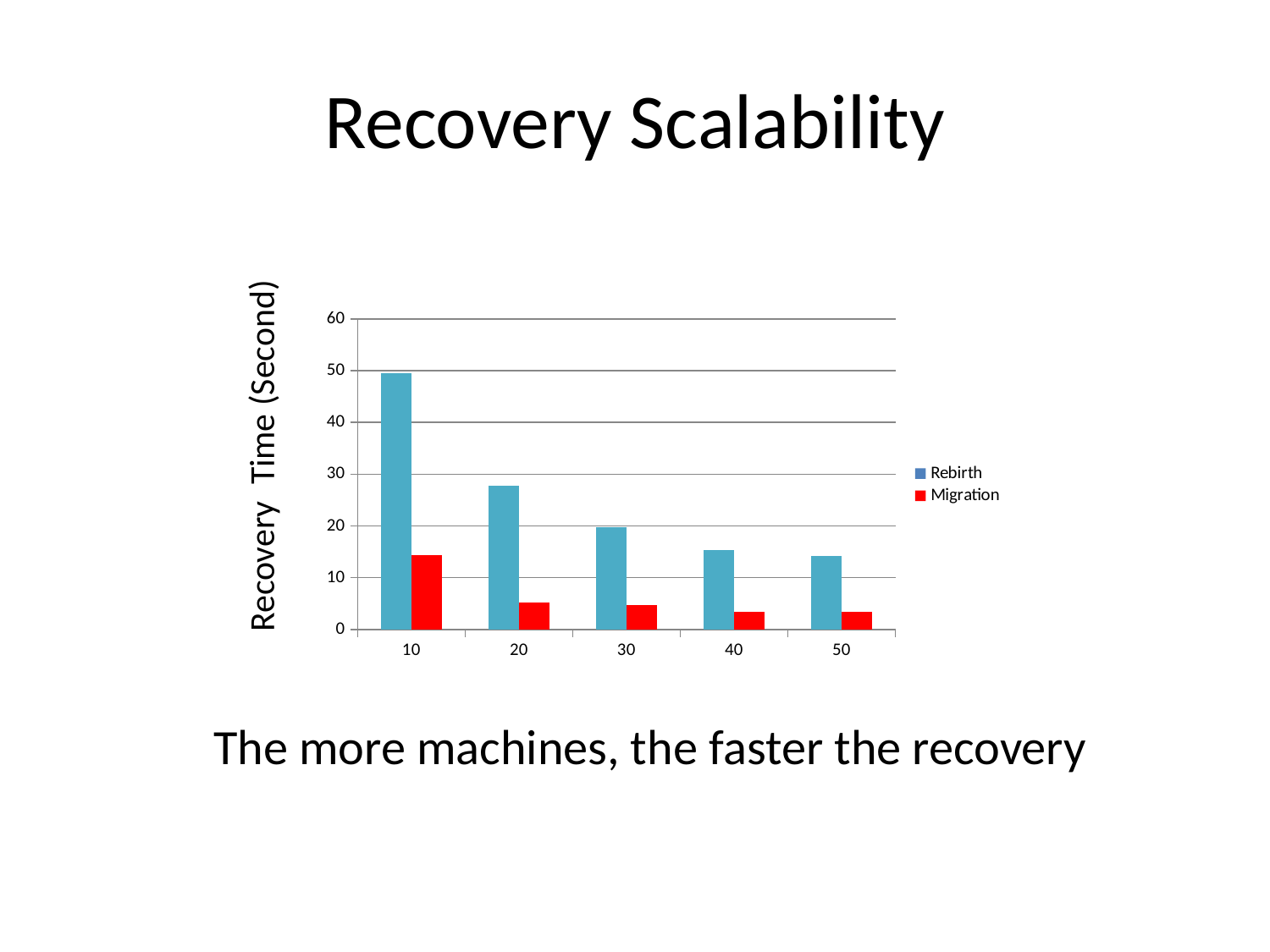
Is the Rebirth value at category 20 greater or less than 30? less How many categories are shown on the x axis? 5 What kind of chart is shown on the slide? bar chart At category 10, which series has the larger value, Rebirth or Migration? Rebirth How many series does the legend list? 2 Do the Rebirth values rise or fall as the x-axis category increases from 10 to 50? fall What is the label of the y axis? Recovery Time (Second) Is the Migration value at category 20 greater or less than 10? less Is the Rebirth value at category 10 greater or less than 40? greater For which x-axis category is the Rebirth value highest? 10 For which x-axis category is the Migration value highest? 10